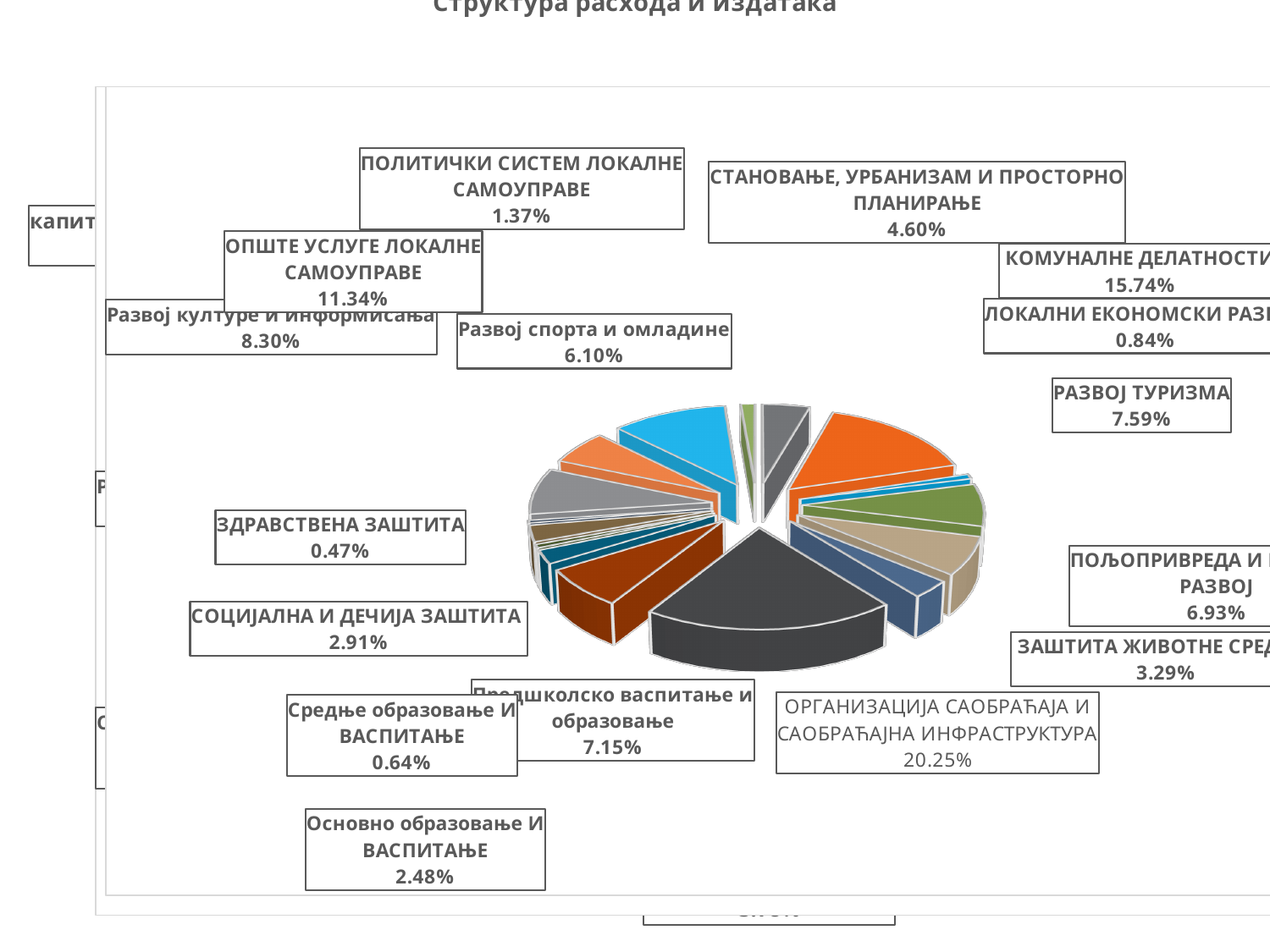
What is the difference in percentage points between КОМУНАЛНЕ ДЕЛАТНОСТИ and ОПШТЕ УСЛУГЕ ЛОКАЛНЕ САМОУПРАВЕ? 4.40 percentage points What share does Предшколско васпитање и образовање have in the pie chart? 7.15% What share does Развој културе и информисања have in the pie chart? 8.30% What share does ЗДРАВСТВЕНА ЗАШТИТА have in the pie chart? 0.47% Which has the larger share: СТАНОВАЊЕ, УРБАНИЗАМ И ПРОСТОРНО ПЛАНИРАЊЕ or СОЦИЈАЛНА И ДЕЧИЈА ЗАШТИТА? СТАНОВАЊЕ, УРБАНИЗАМ И ПРОСТОРНО ПЛАНИРАЊЕ What is the difference in percentage points between Развој културе и информисања and Развој спорта и омладине? 2.20 percentage points What share does ОПШТЕ УСЛУГЕ ЛОКАЛНЕ САМОУПРАВЕ have in the pie chart? 11.34% Which category has the largest share in the pie chart? ОРГАНИЗАЦИЈА САОБРАЋАЈА И САОБРАЋАЈНА ИНФРАСТРУКТУРА Which has the larger share: РАЗВОЈ ТУРИЗМА or Средње образовање И ВАСПИТАЊЕ? РАЗВОЈ ТУРИЗМА What share does ОРГАНИЗАЦИЈА САОБРАЋАЈА И САОБРАЋАЈНА ИНФРАСТРУКТУРА have in the pie chart? 20.25% What share does КОМУНАЛНЕ ДЕЛАТНОСТИ have in the pie chart? 15.74% What kind of chart is shown on the slide? Pie chart